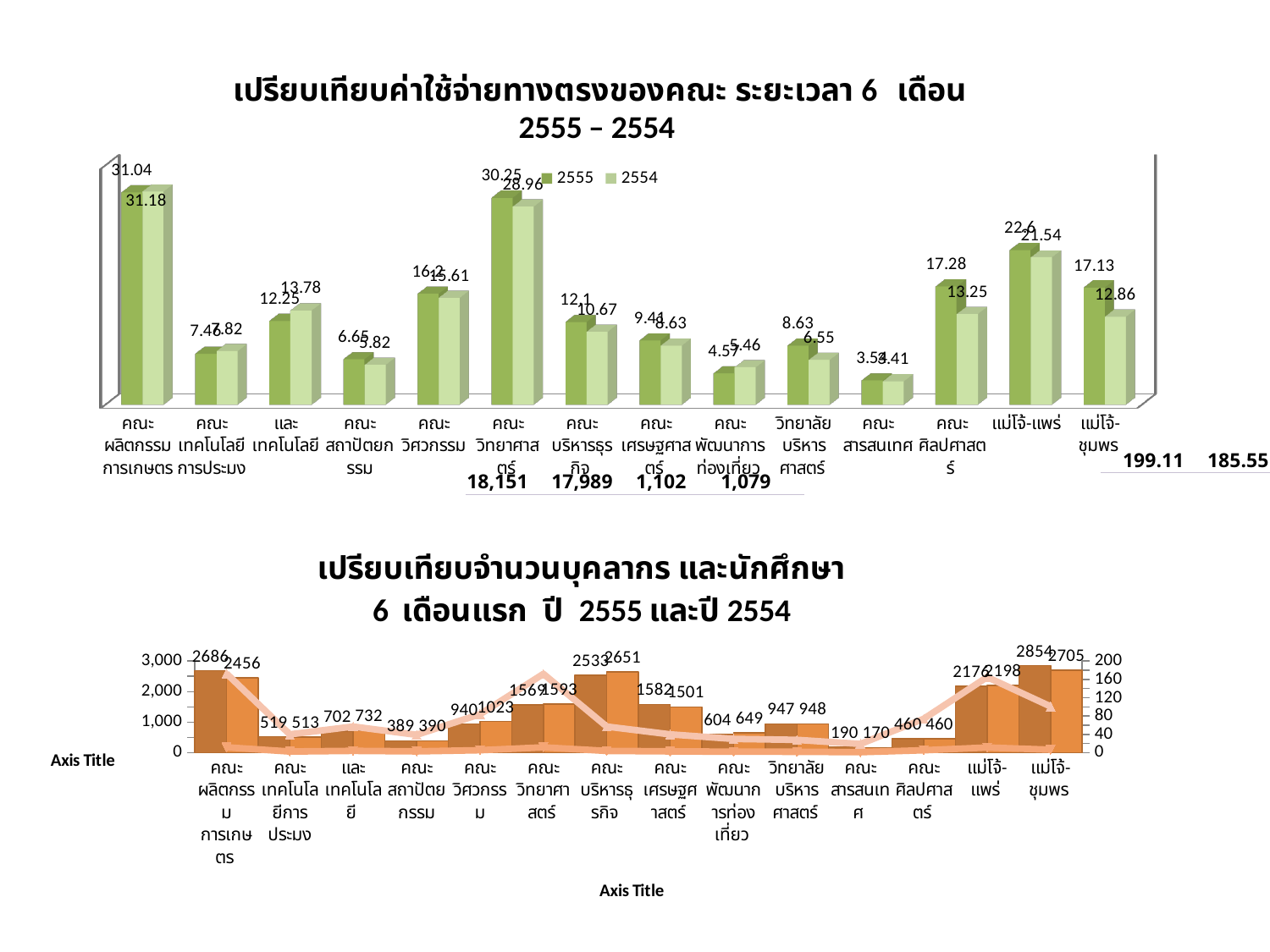
In the top chart, what is the 2554 value for คณะศิลปศาสตร์? 13.25 In the top chart, what is the 2555 value for คณะวิทยาศาสตร์? 30.25 In the top chart, which faculty has the highest 2554 value? คณะผลิตกรรมการเกษตร How many series does the legend of the top chart list? 2 In the bottom chart, what is the difference between the two bar values for คณะผลิตกรรมการเกษตร? 230 In the bottom chart, what is the first (left) bar value for คณะบริหารธุรกิจ? 2533 In the top chart, what is the difference between the 2555 and 2554 values for แม่โจ้-ชุมพร? 4.27 What type of chart is the top chart? Bar chart In the bottom chart, which category has the highest bar value? แม่โจ้-ชุมพร How many categories are shown on the x axis of the bottom chart? 14 In the top chart, which faculty has the lowest 2555 value? คณะสารสนเทศ In the top chart, which is larger for คณะพัฒนาการท่องเที่ยว: the 2555 value or the 2554 value? 2554